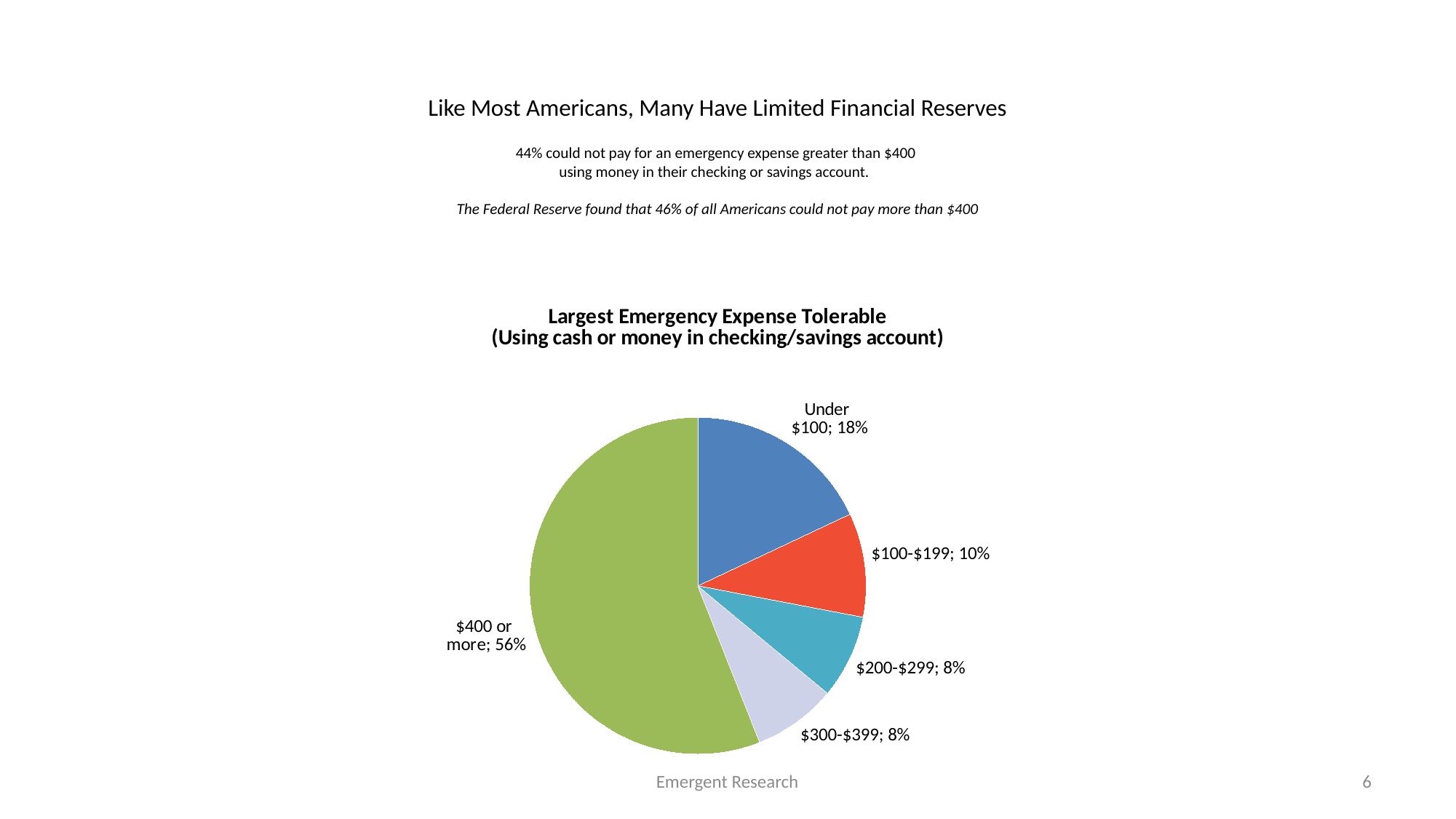
What share of the pie is the "$400 or more" slice? 56% What kind of chart is shown on the slide? pie chart What is the value for the "Under $100" slice? 18% What is the difference between the "$400 or more" slice and the "Under $100" slice? 38% What colour is the "$400 or more" slice? green What is the combined share of the "$200-$299" and "$300-$399" slices? 16% What is the value for the "$100-$199" slice? 10% Which category has the largest slice of the pie? $400 or more Which is larger, the "Under $100" slice or the "$100-$199" slice? Under $100 What is the title of the pie chart? Largest Emergency Expense Tolerable (Using cash or money in checking/savings account) How many slices does the pie chart have? 5 What is the value for the "$200-$299" slice? 8%